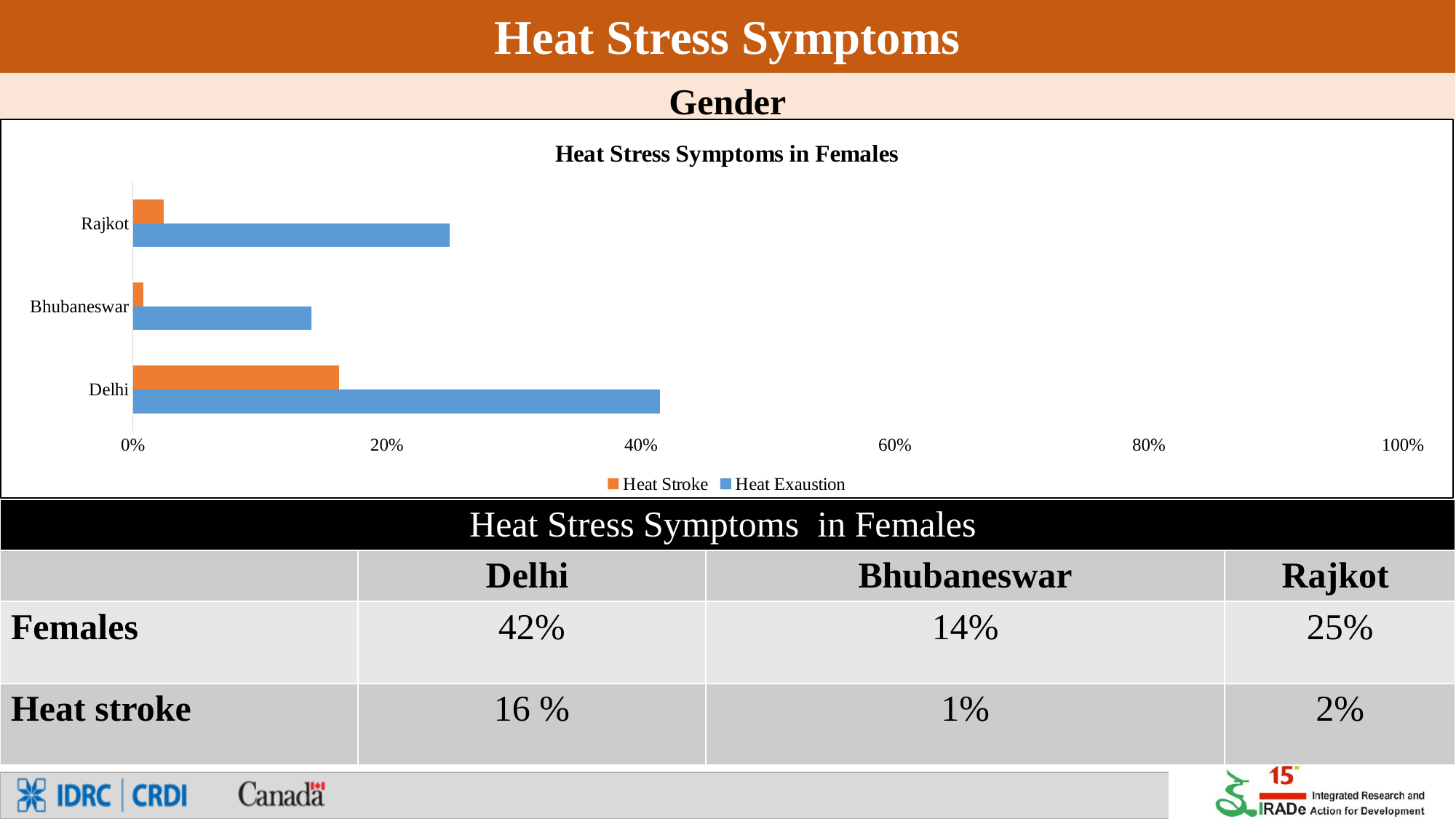
Which city has the highest Heat Exaustion value in the chart? Delhi Is the Heat Exaustion value for Delhi greater or less than 20%? greater Which city has the highest Heat Stroke value in the chart? Delhi How many series does the chart legend list? 2 Which city has the lowest Heat Exaustion value in the chart? Bhubaneswar What colour represents Heat Stroke in the chart? orange How many cities are shown on the y axis of the chart? 3 What is the title of the chart? Heat Stress Symptoms in Females What type of chart is shown on the slide? bar chart Which is larger, the Heat Exaustion value for Rajkot or for Bhubaneswar? Rajkot Is the Heat Stroke value for Rajkot greater or less than 20%? less For Delhi, which is larger, Heat Stroke or Heat Exaustion? Heat Exaustion